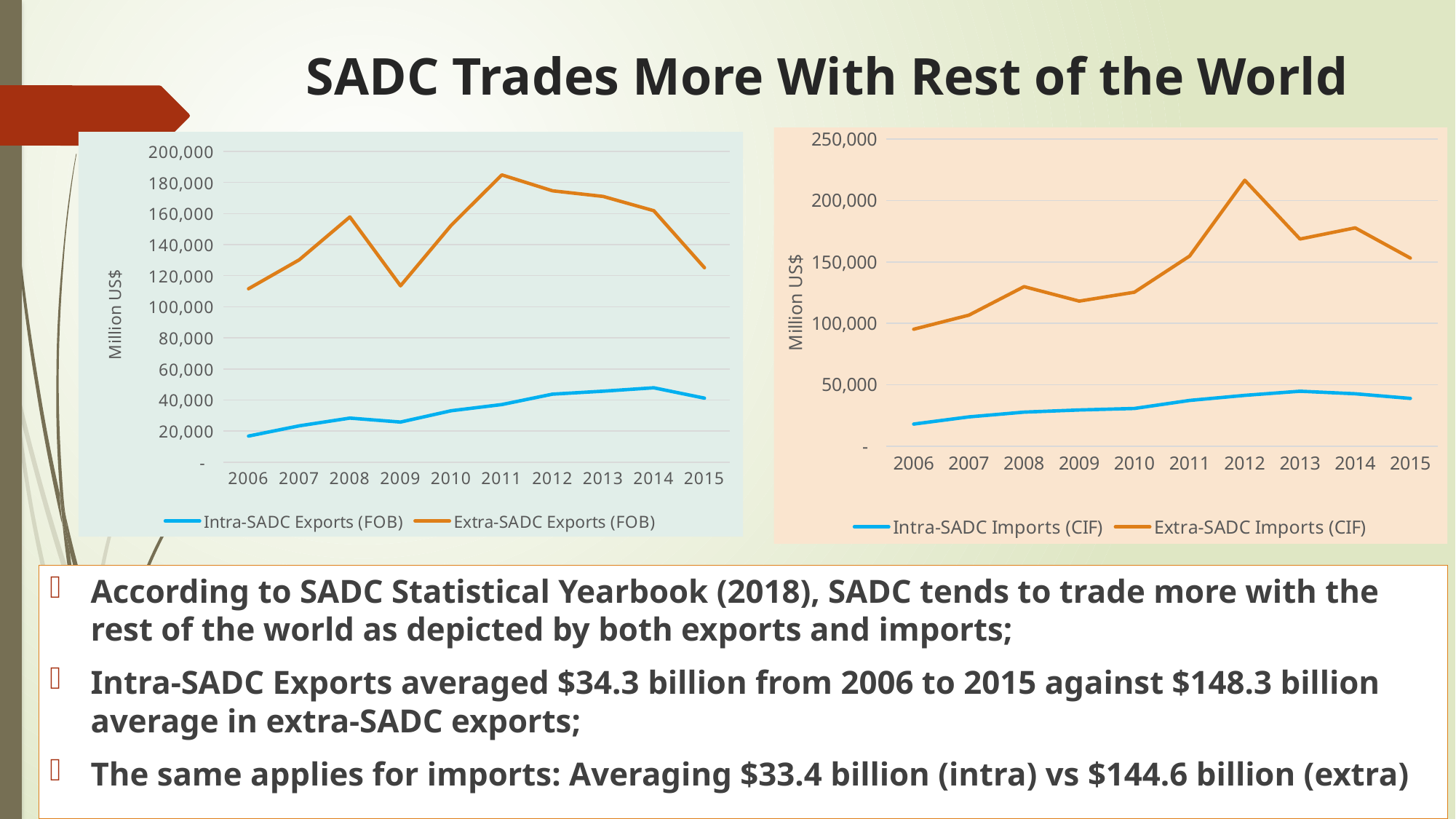
What is the y-axis label on the left chart (Exports)? Million US$ In the right chart (Imports), in which year do Extra-SADC Imports (CIF) reach their highest value? 2012 In the right chart (Imports), do Intra-SADC Imports (CIF) generally rise or fall from 2006 to 2013? Rise In the right chart (Imports), is the value for Intra-SADC Imports (CIF) in 2013 greater or less than 50,000? less In the left chart (Exports), which is larger: Extra-SADC Exports (FOB) in 2008 or in 2009? 2008 What type of chart is the left chart showing Intra-SADC and Extra-SADC Exports? Line chart How many series does the legend of the right chart (Imports) list? 2 How many years are plotted along the x axis of the left chart (Exports)? 10 In the right chart (Imports), is the value for Extra-SADC Imports (CIF) in 2012 greater or less than 200,000? greater In the left chart (Exports), is the value for Extra-SADC Exports (FOB) in 2009 greater or less than 120,000? less In the left chart (Exports), in which year are Extra-SADC Exports (FOB) lowest? 2006 In the left chart (Exports), in which year do Extra-SADC Exports (FOB) reach their highest value? 2011